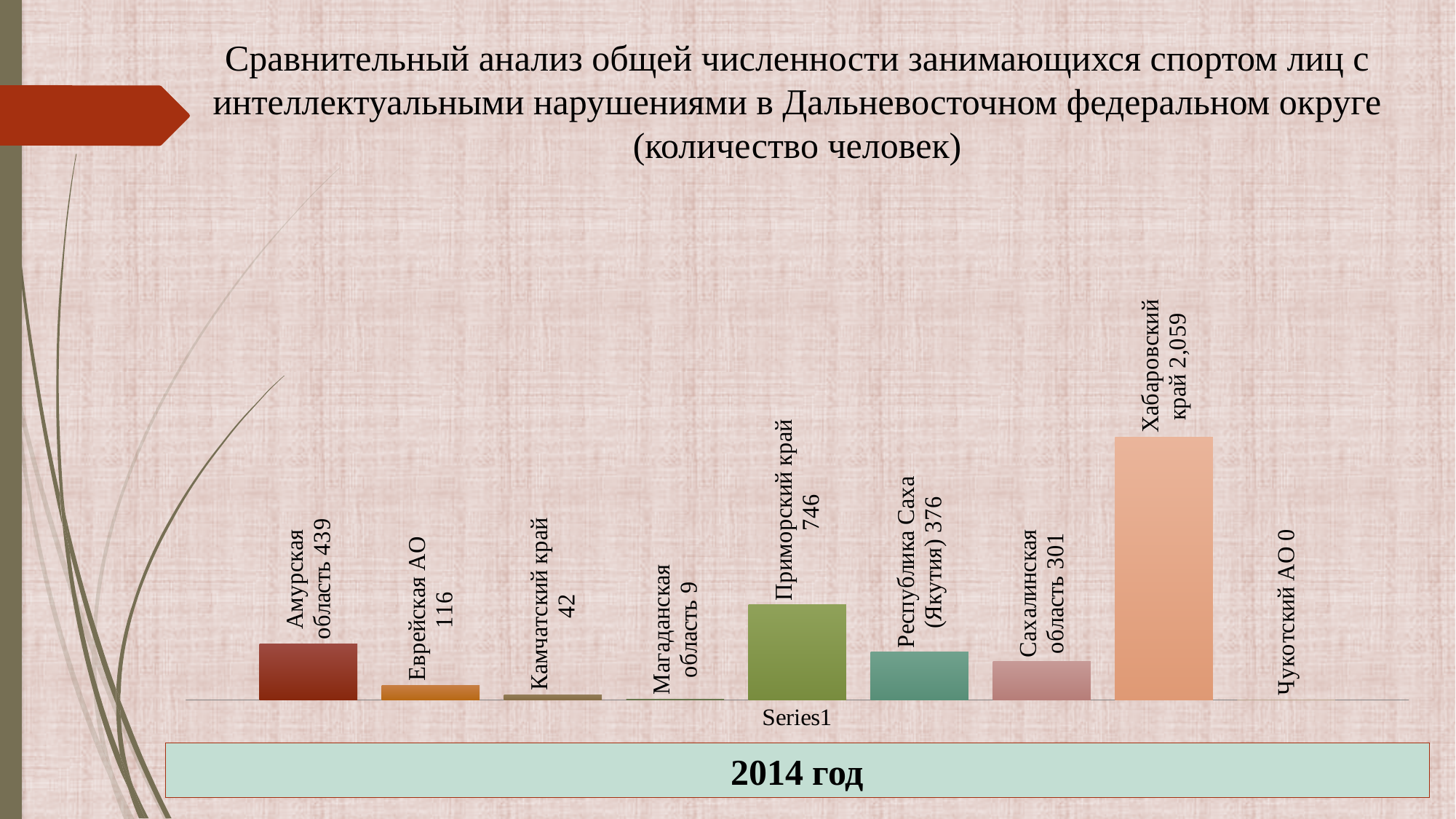
What year is shown in the box below the chart? 2014 год What kind of chart is shown on the slide? bar chart How many regions are shown in the chart? 9 What is the difference between the values for Хабаровский край and Приморский край? 1,313 Which is larger, the value for Еврейская АО or the value for Камчатский край? Еврейская АО What is the value for Приморский край? 746 What is the value for Республика Саха (Якутия)? 376 What is the difference between the values for Амурская область and Сахалинская область? 138 What is the value for Магаданская область? 9 Which region has the lowest value? Чукотский АО What is the value for Хабаровский край? 2,059 Which region has the highest value? Хабаровский край